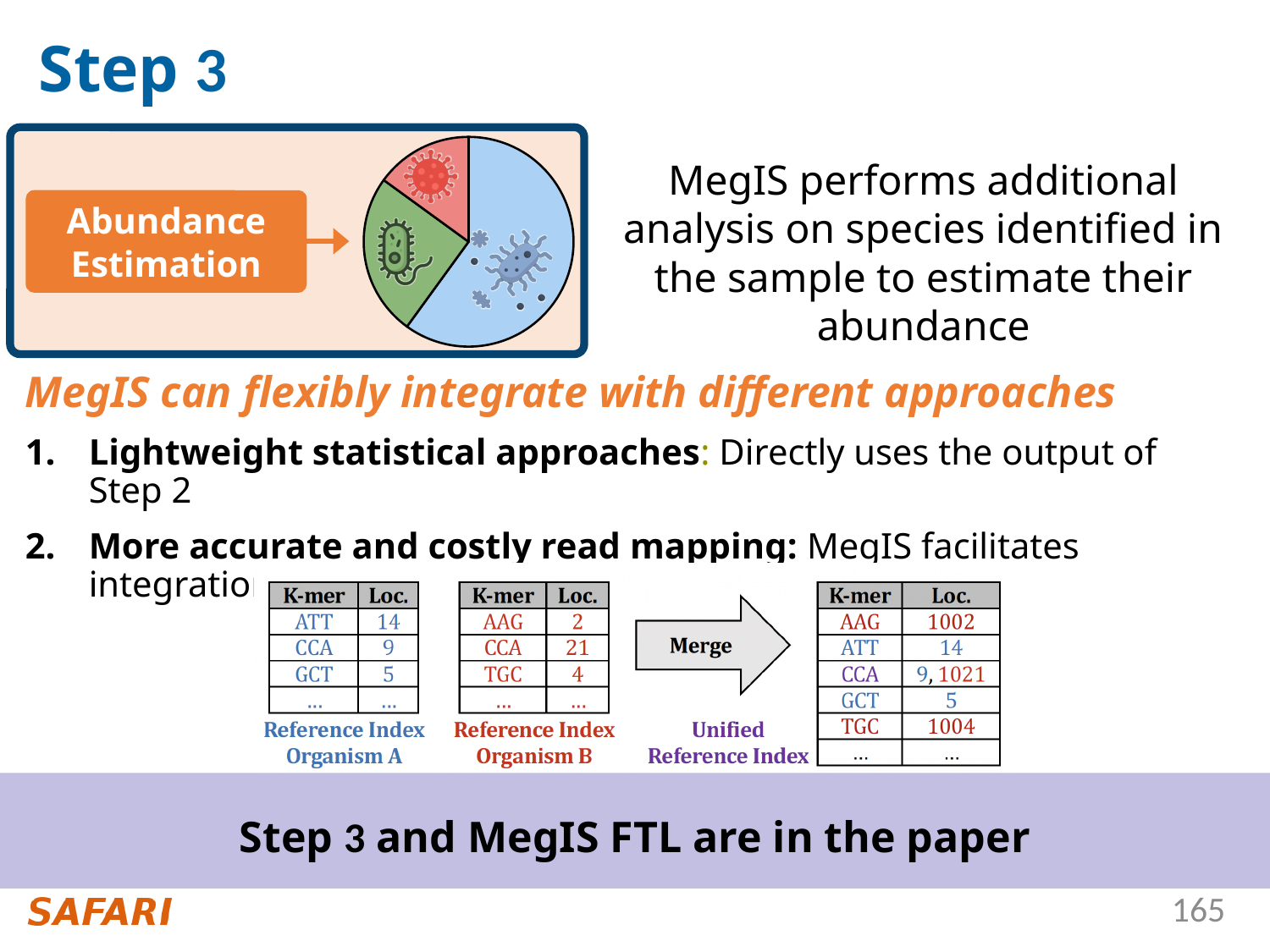
Which colour slice is the largest in the pie chart in the Abundance Estimation box? blue What kind of chart is shown inside the Abundance Estimation box? pie chart In the pie chart in the Abundance Estimation box, is the green slice larger or smaller than the red slice? larger What is the label on the orange box pointing to the pie chart? Abundance Estimation Which colour slice is the smallest in the pie chart in the Abundance Estimation box? red How many slices does the pie chart in the Abundance Estimation box have? 3